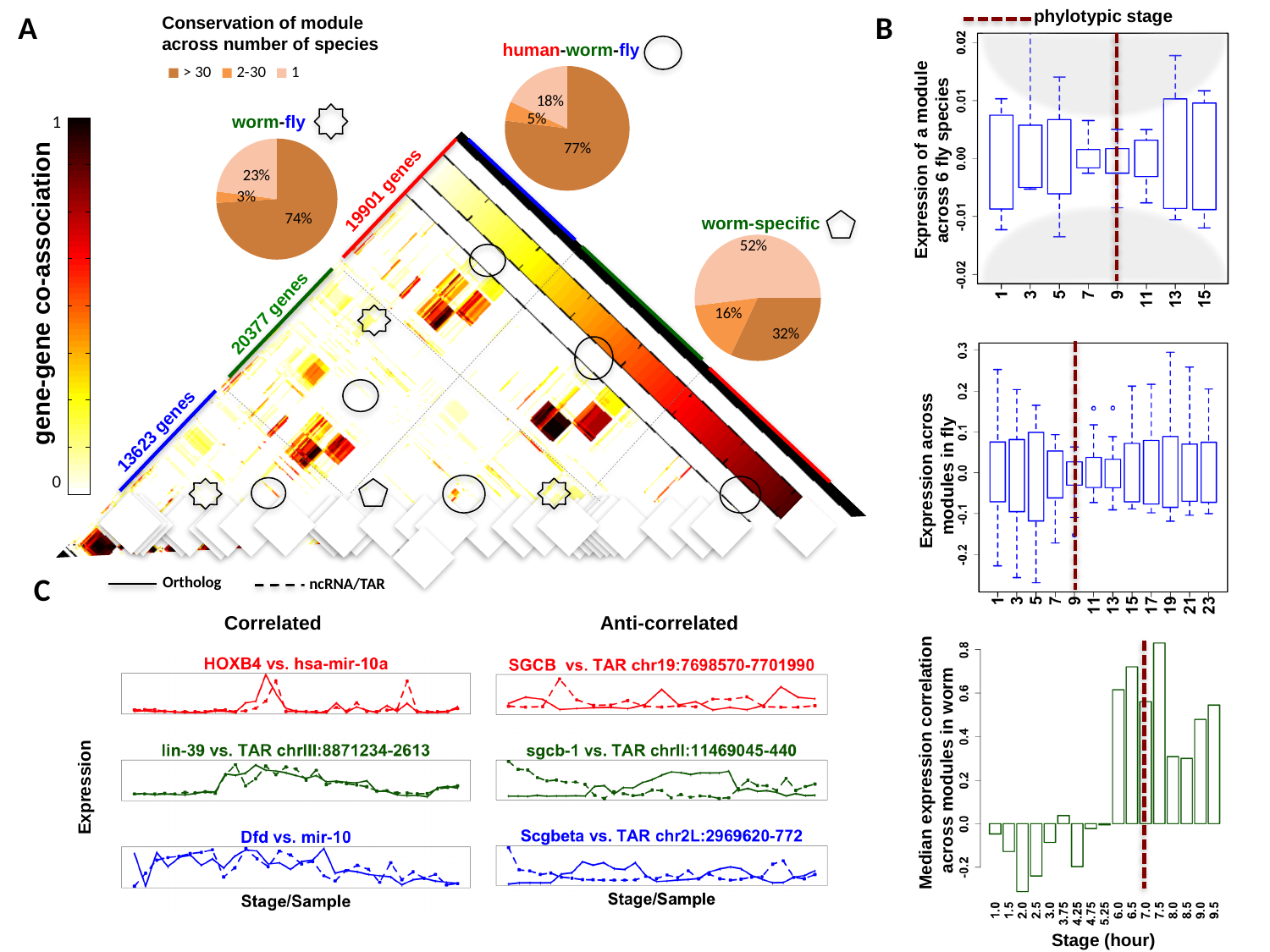
What is the difference in percentage points between the 1-species slice of the worm-fly pie (23%) and that of the human-worm-fly pie (18%)? 5 percentage points In the human-worm-fly pie chart, what is the largest slice's share? 77% What kind of chart is the bottom-right chart showing median expression correlation across modules in worm? bar chart In the bottom-right bar chart (median expression correlation in worm), at which stage (hour) is the dashed phylotypic stage line drawn? 7.0 In the worm-specific pie chart, what share corresponds to the 2-30 species category? 16% In the bottom-right bar chart (median expression correlation in worm), how many stage (hour) categories are on the x axis? 17 In the bottom-right bar chart (median expression correlation in worm), which stage (hour) has the highest bar? 7.5 How many categories does the 'Conservation of module across number of species' legend list? 3 In the worm-fly pie chart, what share of modules is conserved across more than 30 species? 74% Which pie chart has the larger share for the >30 species category, worm-fly or human-worm-fly? human-worm-fly In the worm-specific pie chart, what share of modules is conserved in only 1 species? 52% In the bottom-right bar chart (median expression correlation in worm), is the value at stage 7.5 greater or less than 0.6? greater